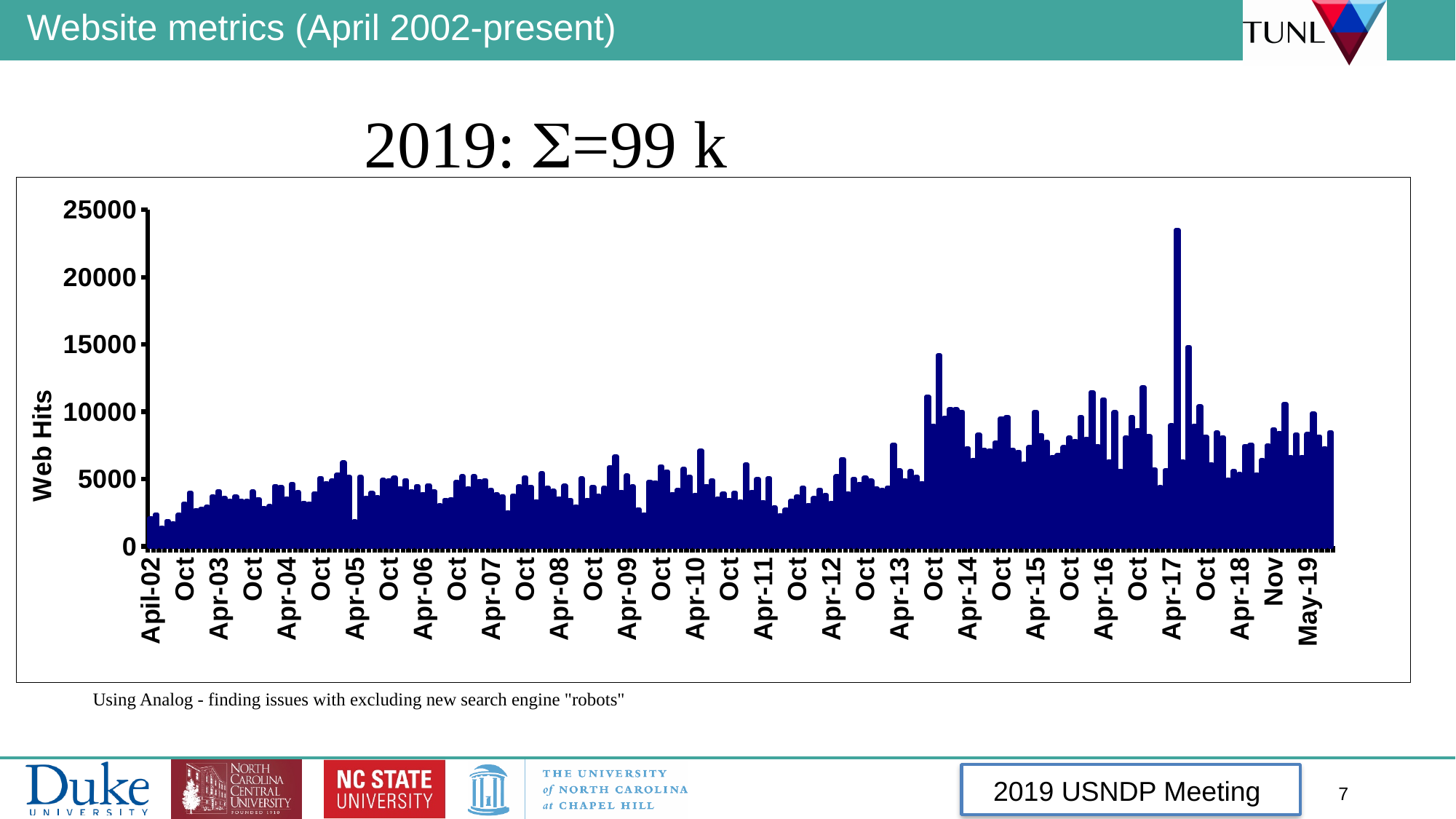
What is the highest value shown on the y axis of the chart? 25000 Which has the larger value, the first bar (Apil-02) or the last bar (May-19)? May-19 Do the web hits generally rise or fall from April 2002 to May 2019? rise Is the value of the tallest bar in the chart (near Apr-17) greater or less than 20000? greater What is the label on the y axis of the chart? Web Hits Is the value for the bar at Apr-05 greater or less than 10000? less Is the value for the last bar (May-19) greater or less than 5000? greater Around which x-axis label does the tallest bar in the chart occur? Apr-17 What kind of chart is shown on the slide? bar chart